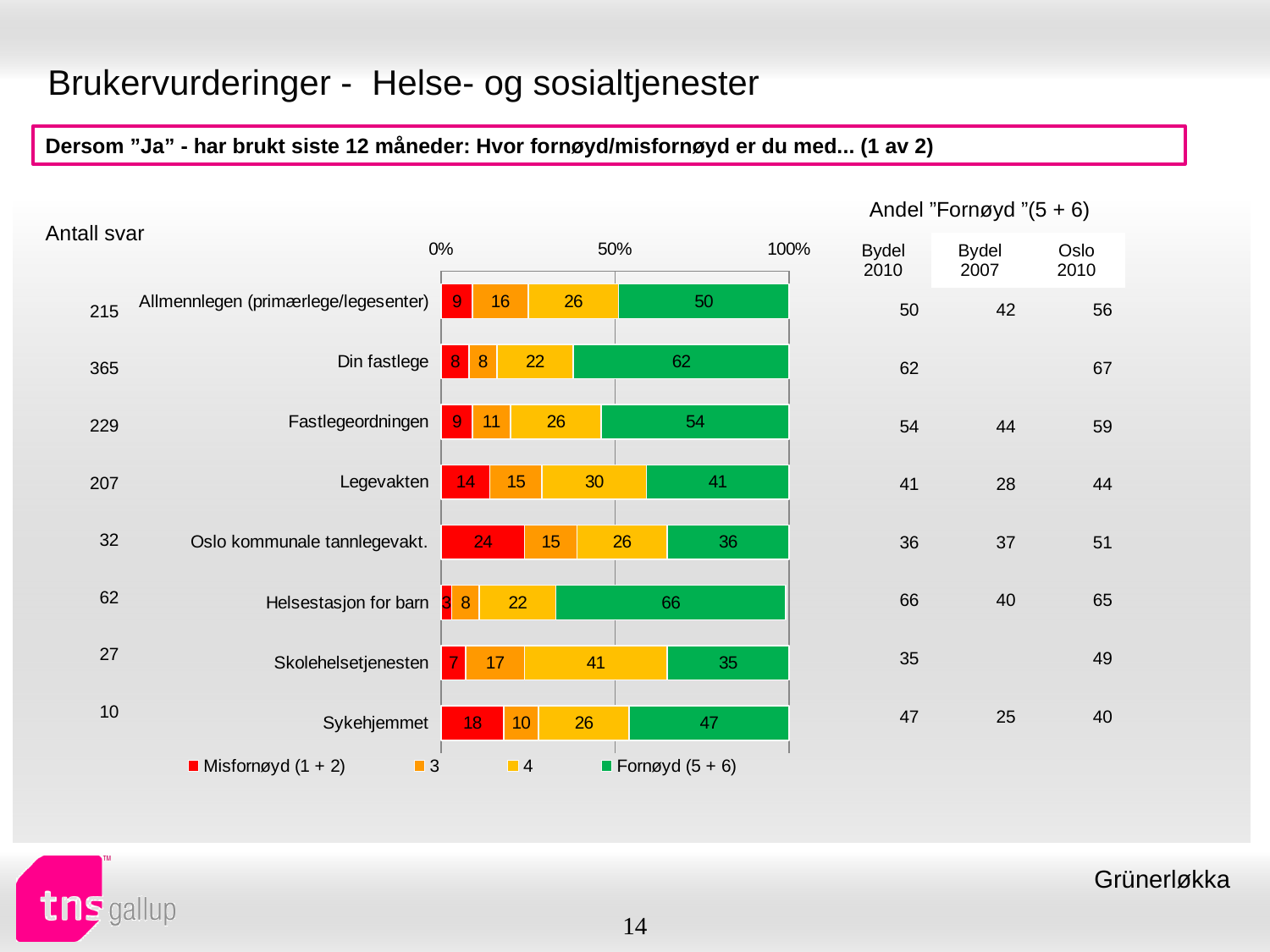
What percentage of respondents are "Fornøyd (5 + 6)" with Din fastlege? 62 What is the "Misfornøyd (1 + 2)" value for Sykehjemmet? 18 What is the value of the "4" segment for Skolehelsetjenesten? 41 Which has a larger "Fornøyd (5 + 6)" value, Allmennlegen (primærlege/legesenter) or Fastlegeordningen? Fastlegeordningen What kind of chart is shown on the slide? Stacked bar chart Which category has the lowest "Misfornøyd (1 + 2)" value? Helsestasjon for barn Which category has the highest "Misfornøyd (1 + 2)" value? Oslo kommunale tannlegevakt. What is the total of the stacked bar for Din fastlege? 100 What is the difference between the "Fornøyd (5 + 6)" values for Din fastlege and Legevakten? 21 How many series does the legend list? 4 Which category has the highest "Fornøyd (5 + 6)" value? Helsestasjon for barn How many categories are shown in the bar chart? 8